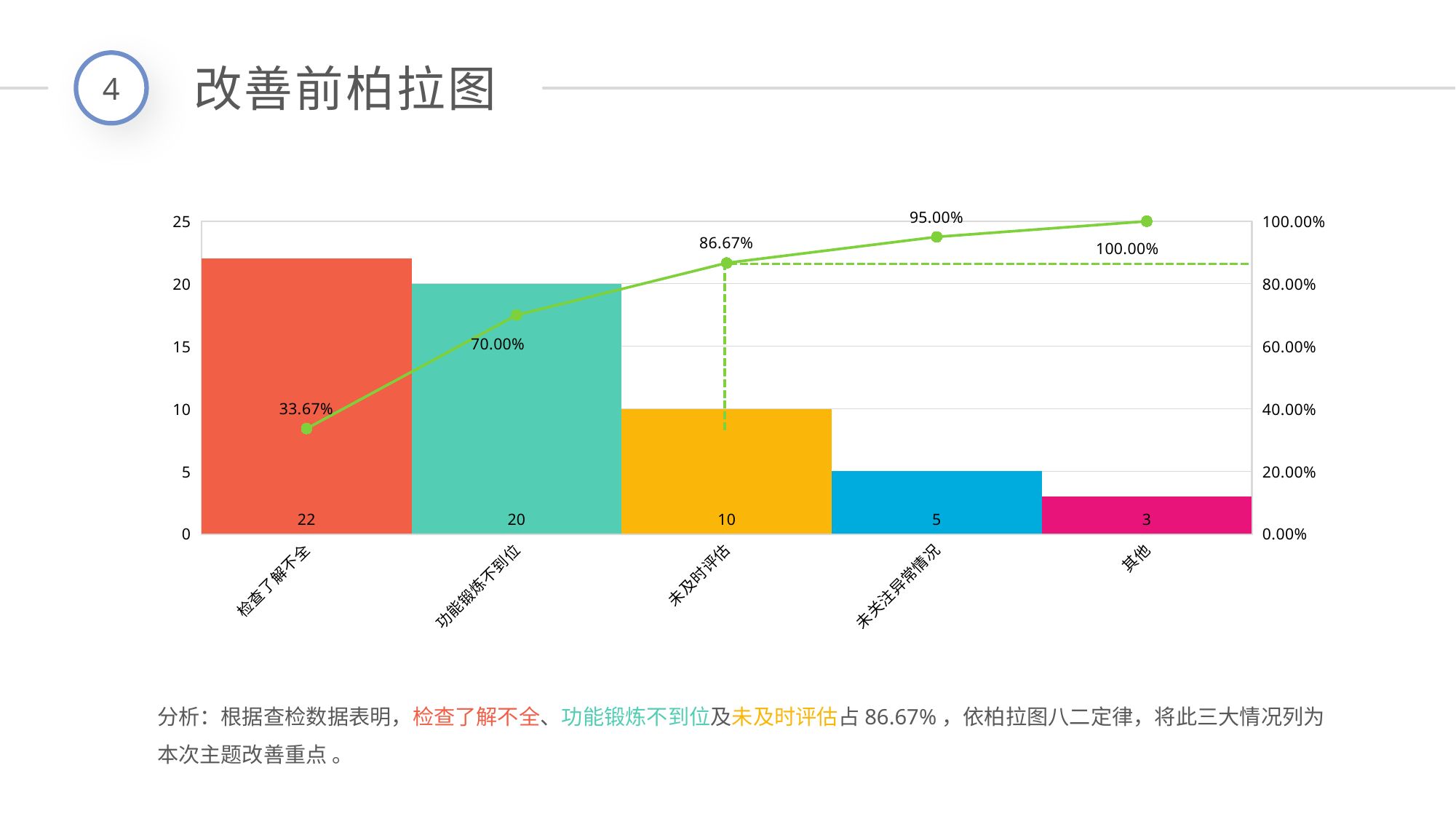
Which category has the highest bar value? 检查了解不全 Which is larger, the value for 未及时评估 or the value for 未关注异常情况? 未及时评估 What is the value for 未及时评估? 10 Do the bar values rise or fall from left to right along the x axis? fall What is the value for 其他? 3 How many categories are shown on the x axis? 5 Which category has the lowest bar value? 其他 What is the difference between the values for 检查了解不全 and 功能锻炼不到位? 2 What is the cumulative percentage at 功能锻炼不到位? 70.00% What is the value for 检查了解不全? 22 What is the cumulative percentage at 未及时评估? 86.67% What is the title of the slide containing the chart? 改善前柏拉图